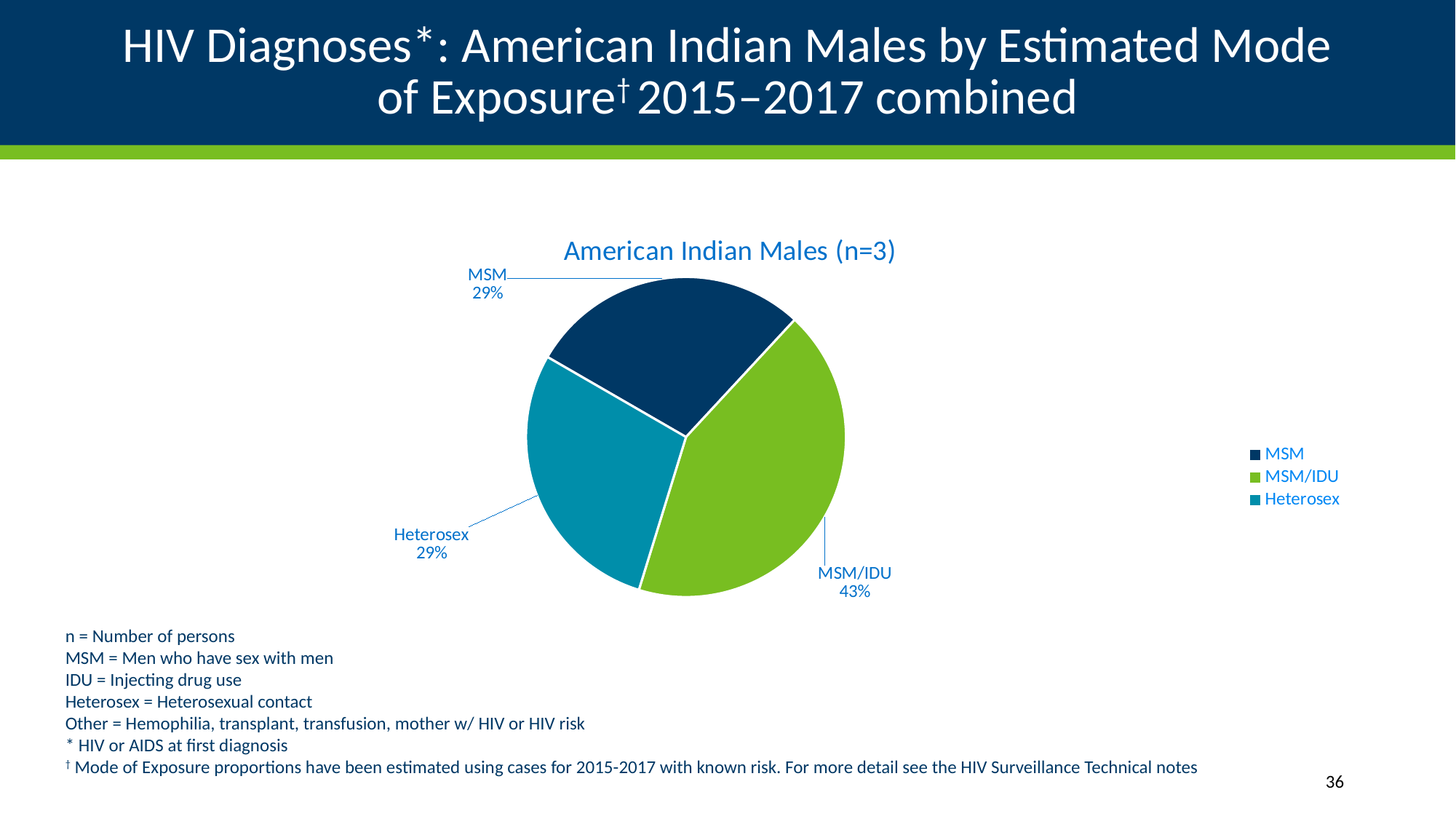
How many entries does the legend list? 3 What colour is the MSM/IDU slice? green What share of the pie does MSM/IDU represent? 43% Which is larger, the share for MSM/IDU or the share for Heterosex? MSM/IDU How many slices does the pie chart have? 3 What share of the pie does MSM represent? 29% What share of the pie does Heterosex represent? 29% What kind of chart is shown on the slide? pie chart What is the difference in percentage points between the MSM/IDU share and the MSM share? 14 Which mode of exposure has the largest share of the pie? MSM/IDU What is the title of the pie chart? American Indian Males (n=3) What is the number of persons (n) shown in the chart title? 3